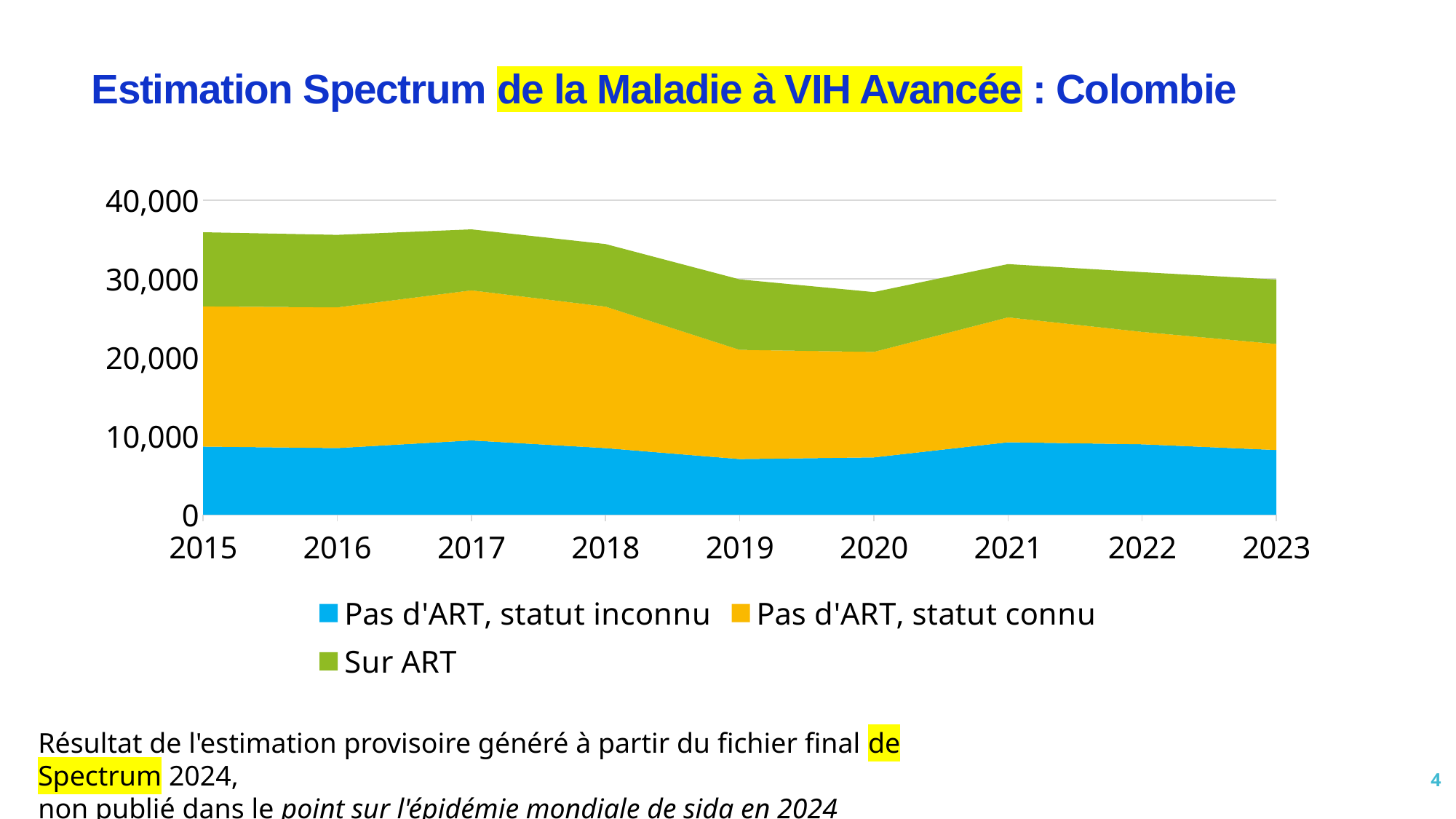
Which series is shown in green? Sur ART Does the total rise or fall from 2020 to 2021? rise Is the total for 2015 greater or less than 30,000? greater Which year has the lowest total across all three series? 2020 How many years are shown along the x axis? 9 Is the total for 2021 greater or less than 30,000? greater How many series does the legend list? 3 Is the value for 'Pas d'ART, statut inconnu' in 2019 greater or less than 10,000? less What kind of chart is shown on the slide? Stacked area chart What is the title of the slide? Estimation Spectrum de la Maladie à VIH Avancée : Colombie Does the total rise or fall from 2017 to 2020? fall